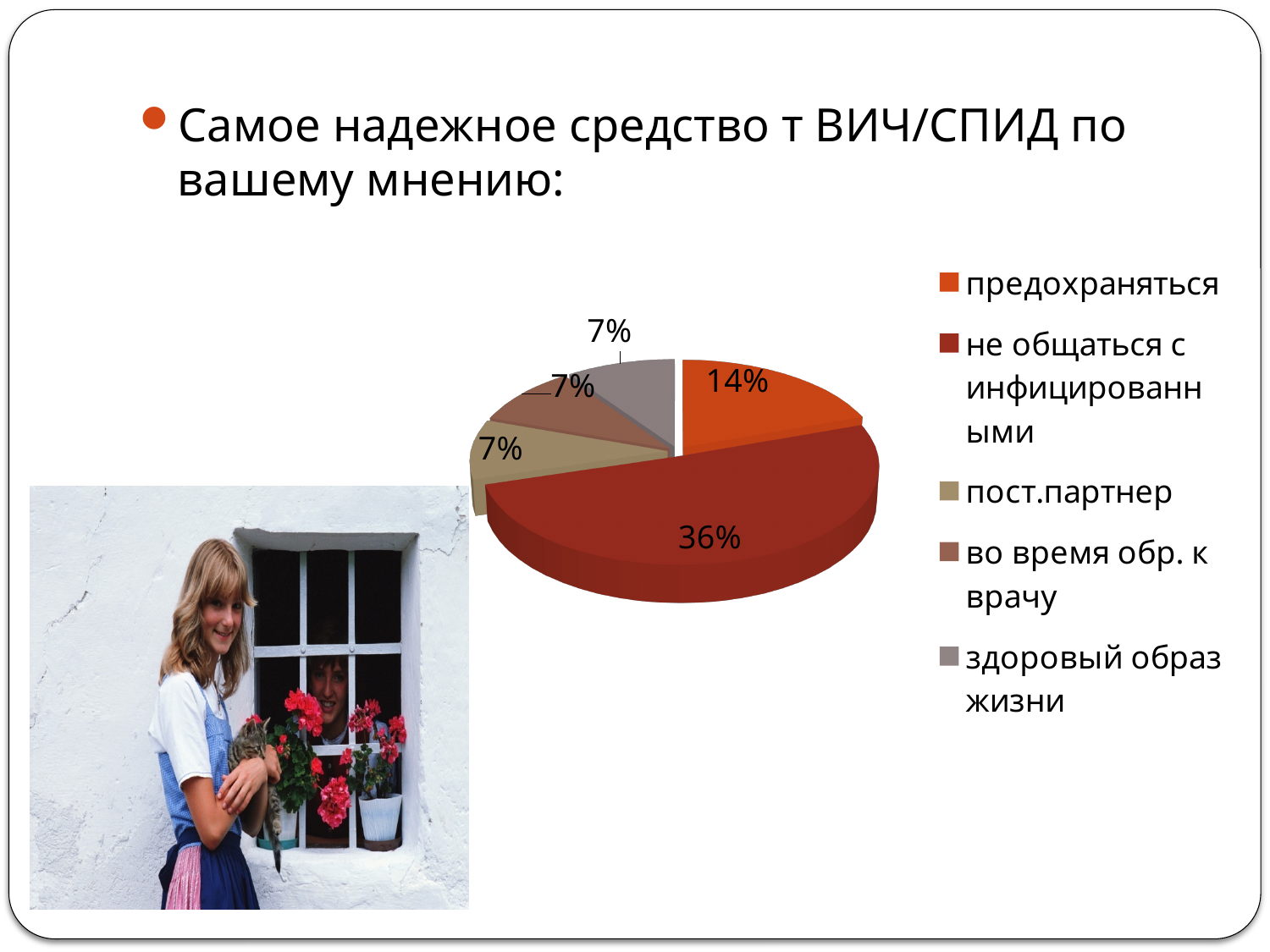
What percentage is shown for the slice "не общаться с инфицированными"? 36% Which category has the largest slice of the pie? не общаться с инфицированными How many entries does the legend list? 5 Which category is shown in the orange colour in the legend? предохраняться What is the difference in percentage points between "не общаться с инфицированными" and "предохраняться"? 22 What kind of chart is shown on the slide? pie chart What is the smallest percentage value printed on the pie chart? 7% What percentage is shown for the slice "здоровый образ жизни"? 7% What percentage is shown for the slice labelled "предохраняться"? 14% Which is larger: the slice for "предохраняться" or the slice for "во время обр. к врачу"? предохраняться How many slices does the pie chart have? 5 What percentage is shown for the slice "пост.партнер"? 7%